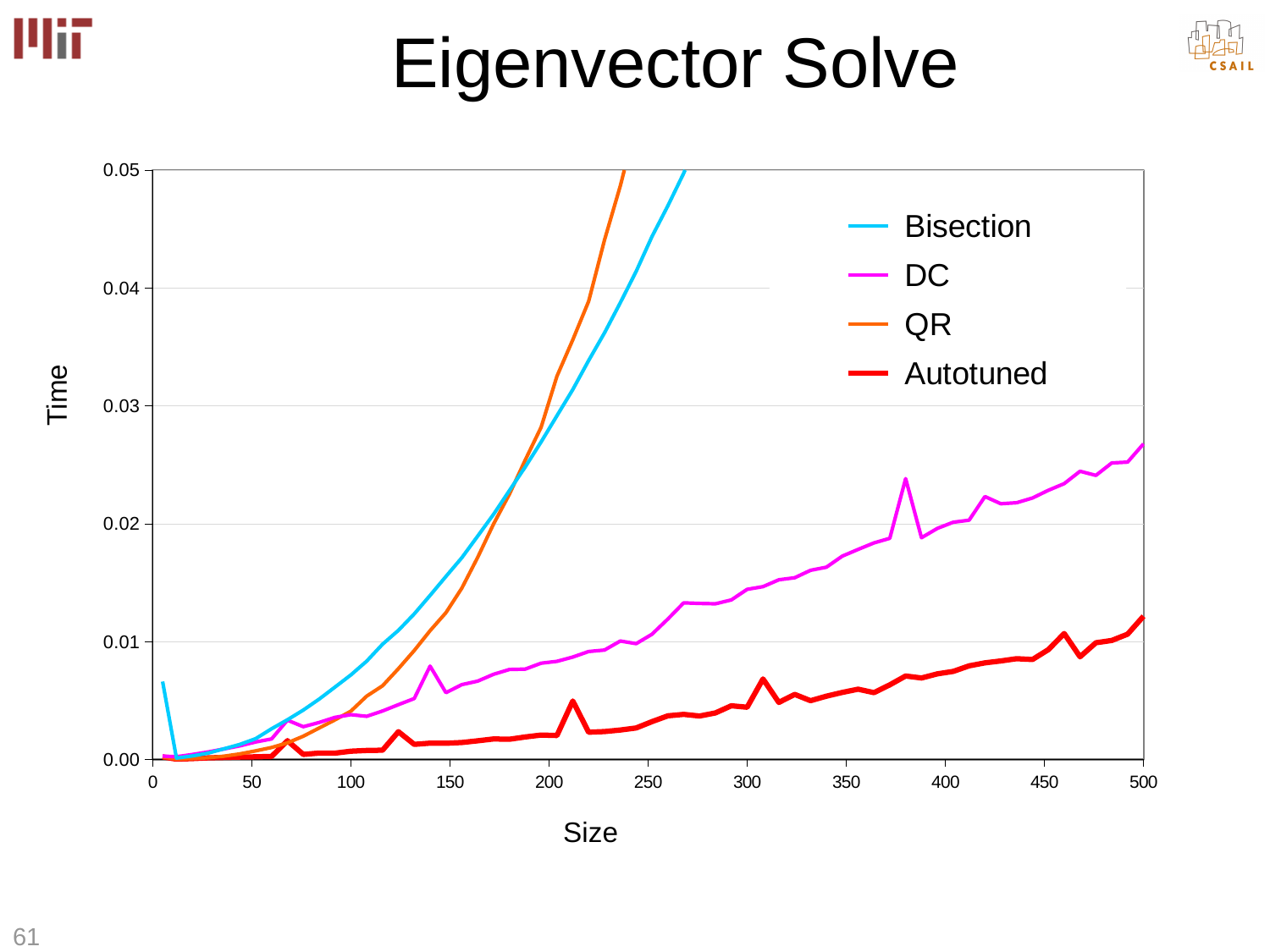
Is the value for DC at Size 300 greater or less than 0.02? less Is the value for Autotuned at Size 500 greater or less than 0.01? greater Is the value for Autotuned at Size 300 greater or less than 0.01? less At Size 500, which series has the larger value, DC or Autotuned? DC What kind of chart is shown on the slide? line chart Does the Autotuned series generally rise or fall as Size increases? rise Which series has the lowest value at Size 500? Autotuned What is the label of the x axis? Size What is the title of the chart? Eigenvector Solve How many series does the legend list? 4